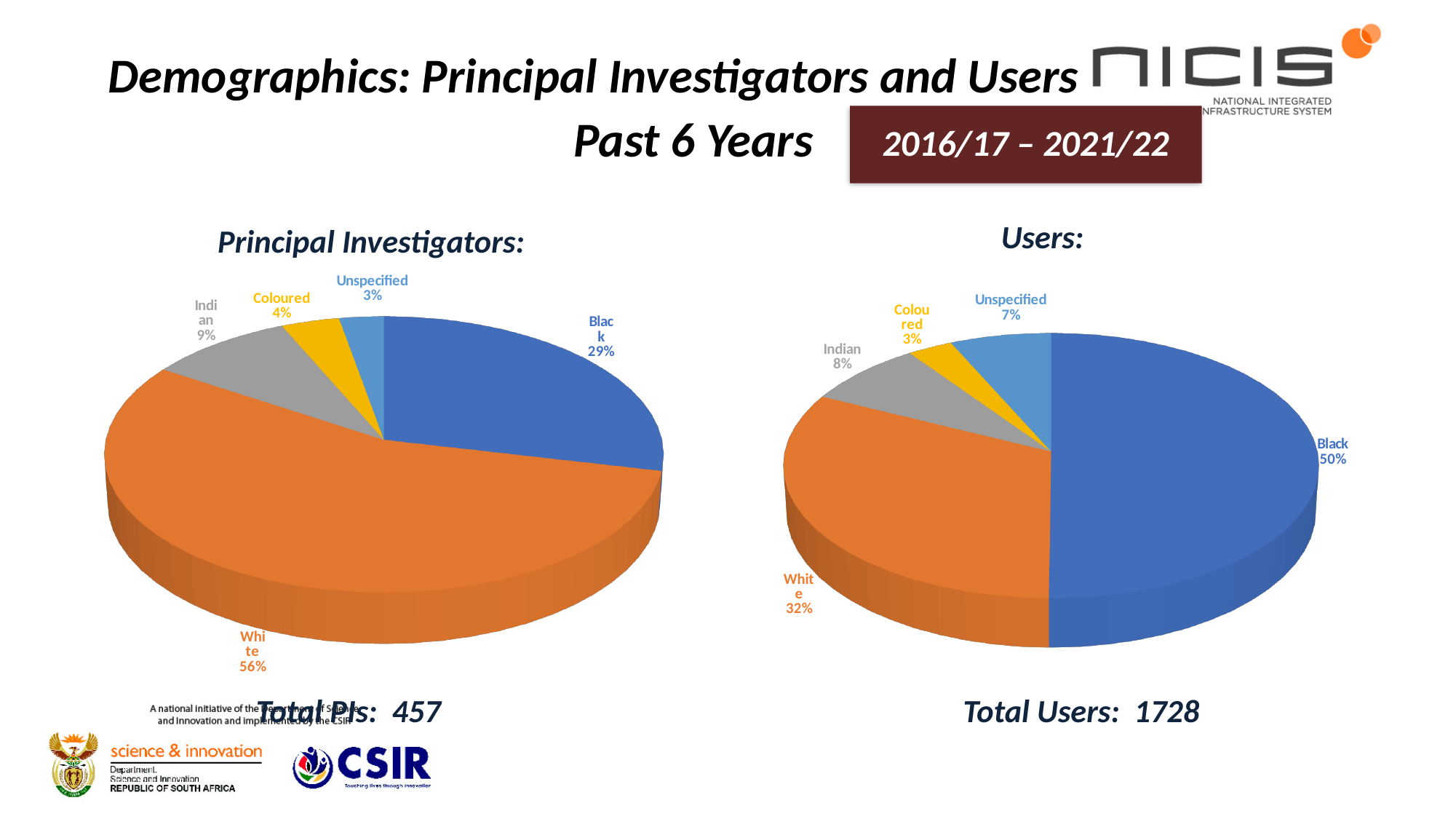
In the Principal Investigators pie chart, which category has the largest slice? White In the Principal Investigators pie chart, what is the difference in percentage points between White and Black? 27 In the Users pie chart, what share is labelled for Black? 50% In the Users pie chart, which category has the smallest slice? Coloured In the Users pie chart, which category has the largest slice? Black How many categories does the Users pie chart show? 5 In the Users pie chart, what share is labelled for Unspecified? 7% In the Principal Investigators pie chart, what share is labelled for White? 56% In the Principal Investigators pie chart, what share is labelled for Black? 29% What type of chart is used for the Principal Investigators data? Pie chart In the Principal Investigators pie chart, what share is labelled for Indian? 9% In the Users pie chart, which is larger, the White slice or the Indian slice? White